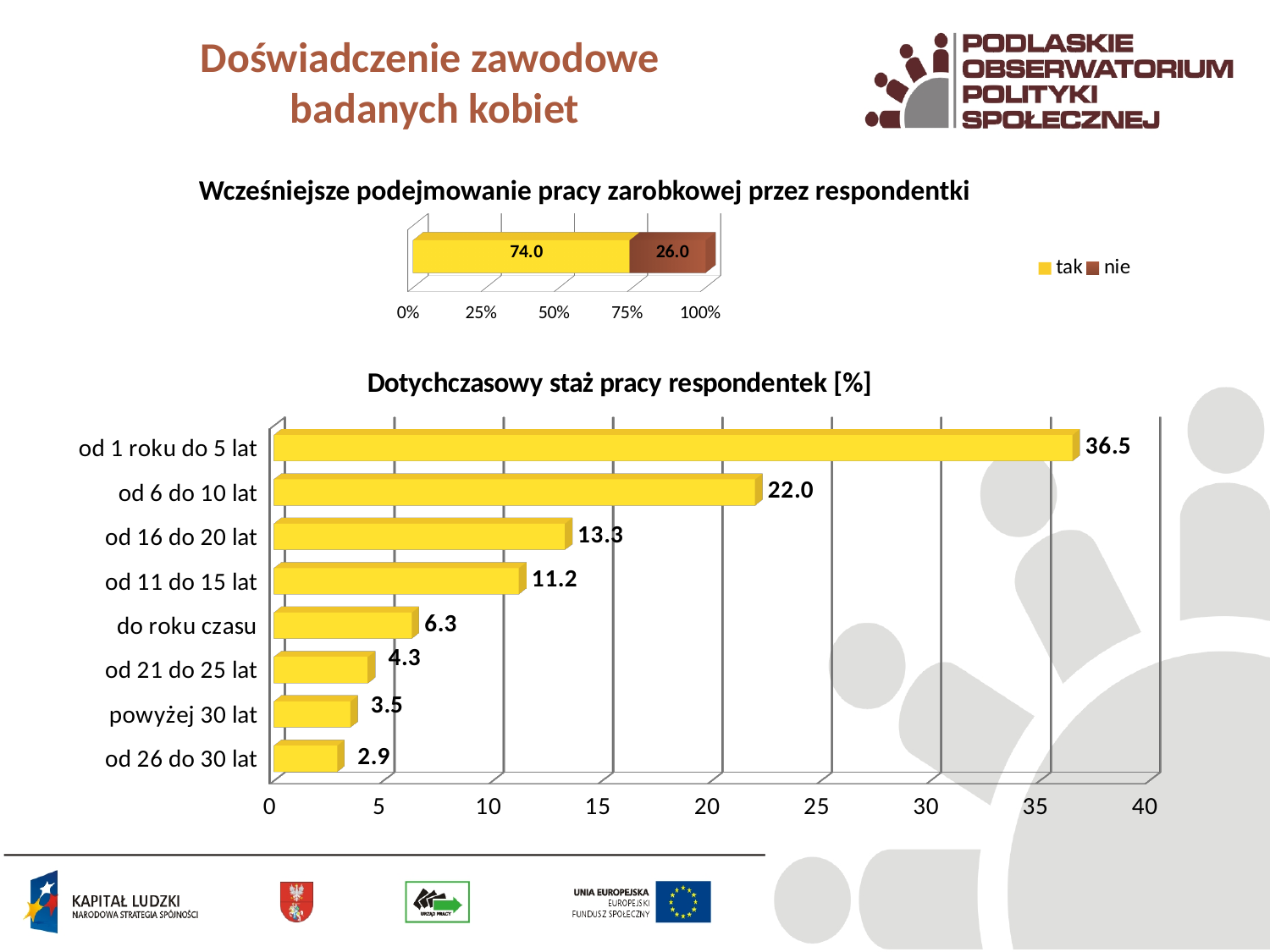
In the chart 'Dotychczasowy staż pracy respondentek [%]', what is the value for 'do roku czasu'? 6.3 In the chart 'Wcześniejsze podejmowanie pracy zarobkowej przez respondentki', what is the value for 'nie'? 26.0 In the chart 'Wcześniejsze podejmowanie pracy zarobkowej przez respondentki', how many series does the legend list? 2 In the chart 'Dotychczasowy staż pracy respondentek [%]', what is the difference between 'od 1 roku do 5 lat' and 'od 6 do 10 lat'? 14.5 In the chart 'Dotychczasowy staż pracy respondentek [%]', which category has the highest value? od 1 roku do 5 lat In the chart 'Dotychczasowy staż pracy respondentek [%]', which is larger: 'od 16 do 20 lat' or 'od 11 do 15 lat'? od 16 do 20 lat What kind of chart is 'Dotychczasowy staż pracy respondentek [%]'? bar chart In the chart 'Wcześniejsze podejmowanie pracy zarobkowej przez respondentki', what is the value for 'tak'? 74.0 In the chart 'Wcześniejsze podejmowanie pracy zarobkowej przez respondentki', what is the difference between the 'tak' and 'nie' values? 48.0 In the chart 'Dotychczasowy staż pracy respondentek [%]', which category has the lowest value? od 26 do 30 lat In the chart 'Dotychczasowy staż pracy respondentek [%]', what is the value for 'od 6 do 10 lat'? 22.0 In the chart 'Dotychczasowy staż pracy respondentek [%]', how many categories are shown? 8